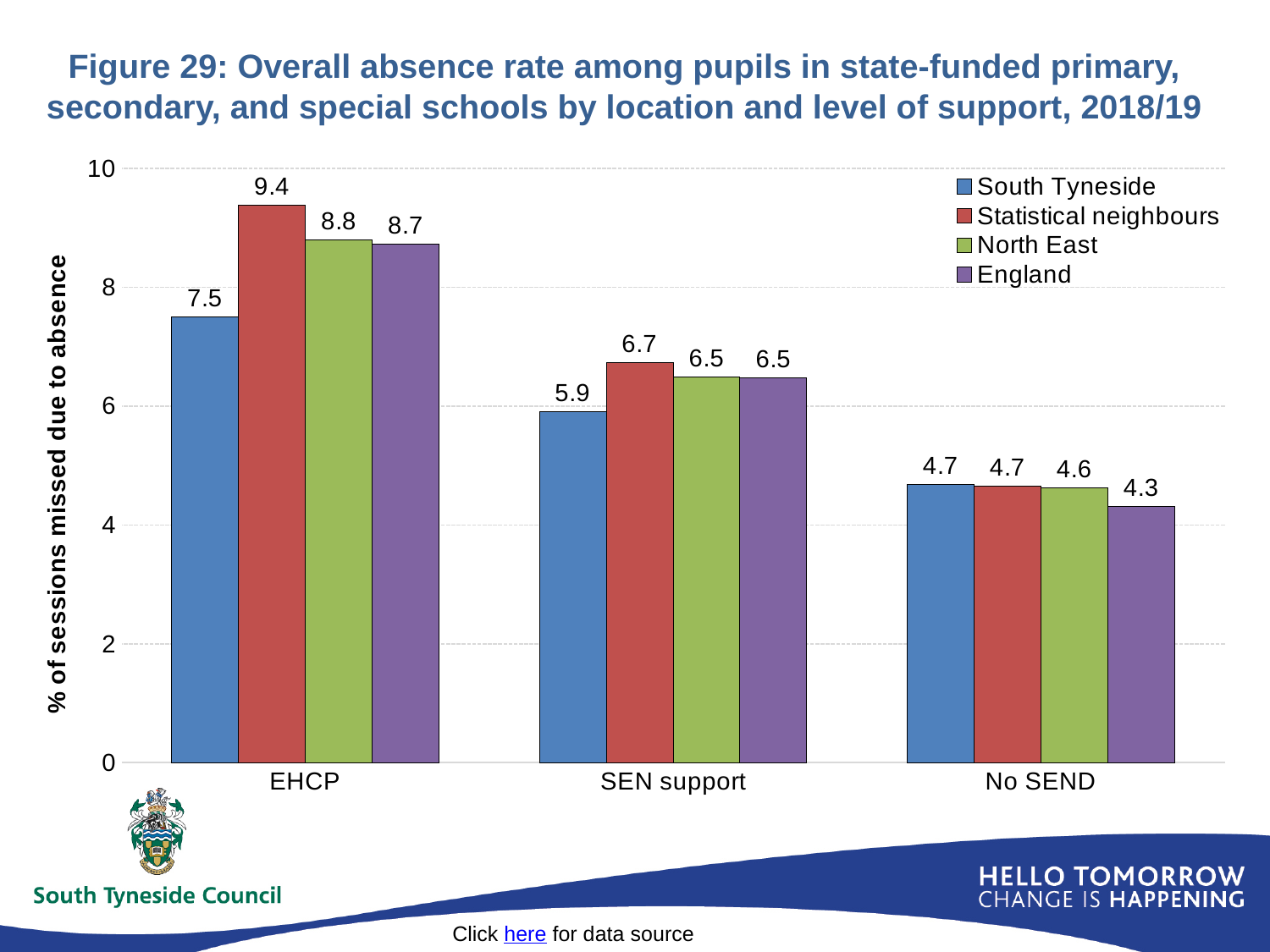
Do the South Tyneside absence rates rise or fall moving from EHCP to No SEND along the x axis? Fall What is the absence rate for England in the No SEND category? 4.3 What is the absence rate for Statistical neighbours in the SEN support category? 6.7 How many series does the legend list? 4 Which series has the lowest absence rate in the No SEND category? England How many categories of level of support are shown on the x axis? 3 What is the overall absence rate for South Tyneside pupils with an EHCP? 7.5 What is the difference between the Statistical neighbours and South Tyneside absence rates for EHCP? 1.9 Which series has the highest absence rate in the EHCP category? Statistical neighbours Which is larger: the North East absence rate for EHCP or the England absence rate for EHCP? North East What kind of chart is shown on the slide? Bar chart Is the South Tyneside absence rate for SEN support greater or less than 6? less